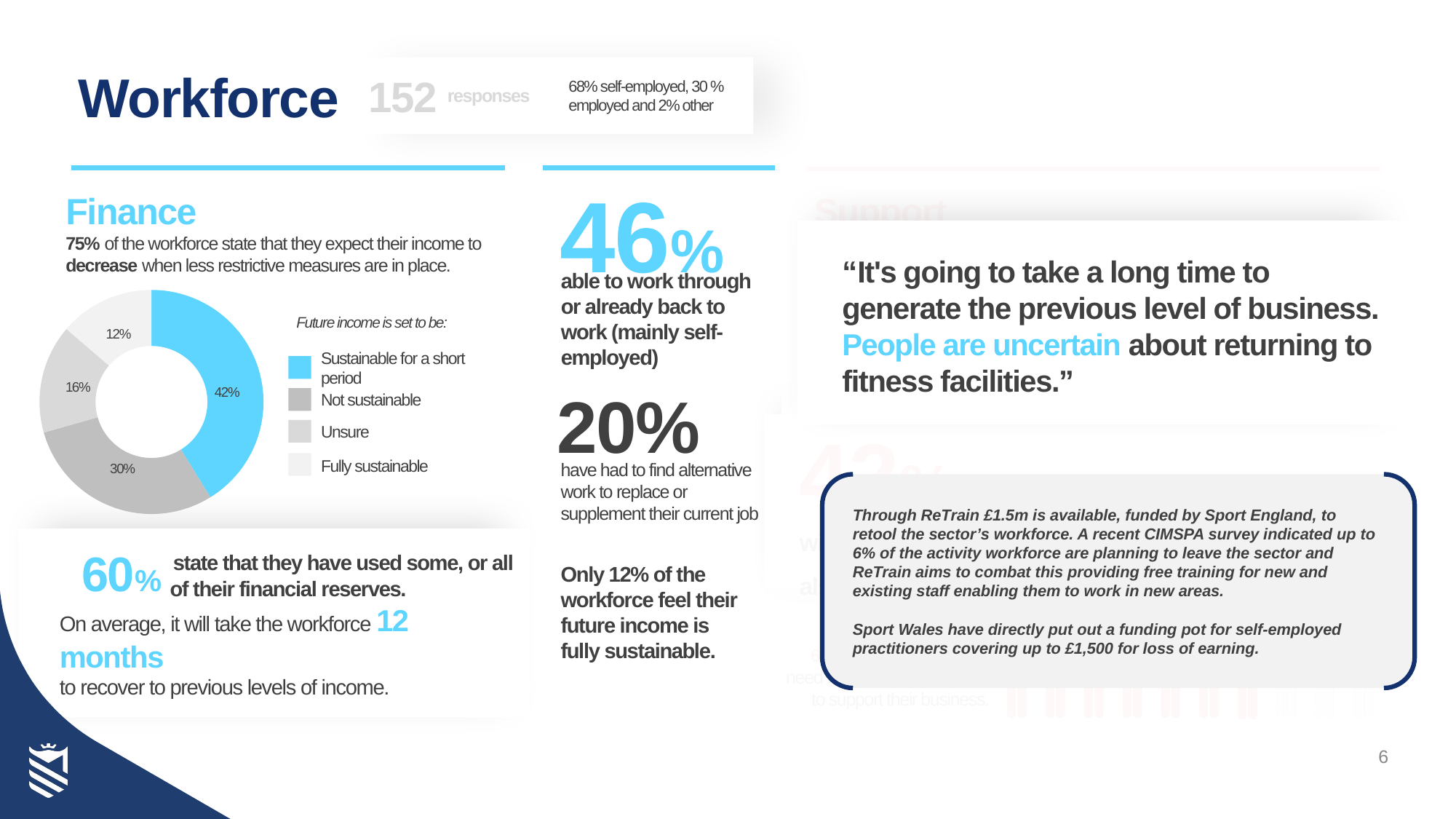
What share of the pie chart is 'Unsure'? 16% What share of the pie chart is 'Fully sustainable'? 12% What share of the pie chart is 'Sustainable for a short period'? 42% What colour is the 'Sustainable for a short period' slice in the pie chart? Light blue What share of the pie chart is 'Not sustainable'? 30% Which category has the largest slice in the pie chart? Sustainable for a short period How many entries does the pie chart's legend list? 4 What kind of chart is shown under the Finance heading? Pie chart (donut) How many categories does the pie chart show? 4 Which category has the smallest slice in the pie chart? Fully sustainable Which is larger in the pie chart: 'Unsure' or 'Fully sustainable'? Unsure What is the difference in percentage points between 'Sustainable for a short period' and 'Not sustainable' in the pie chart? 12